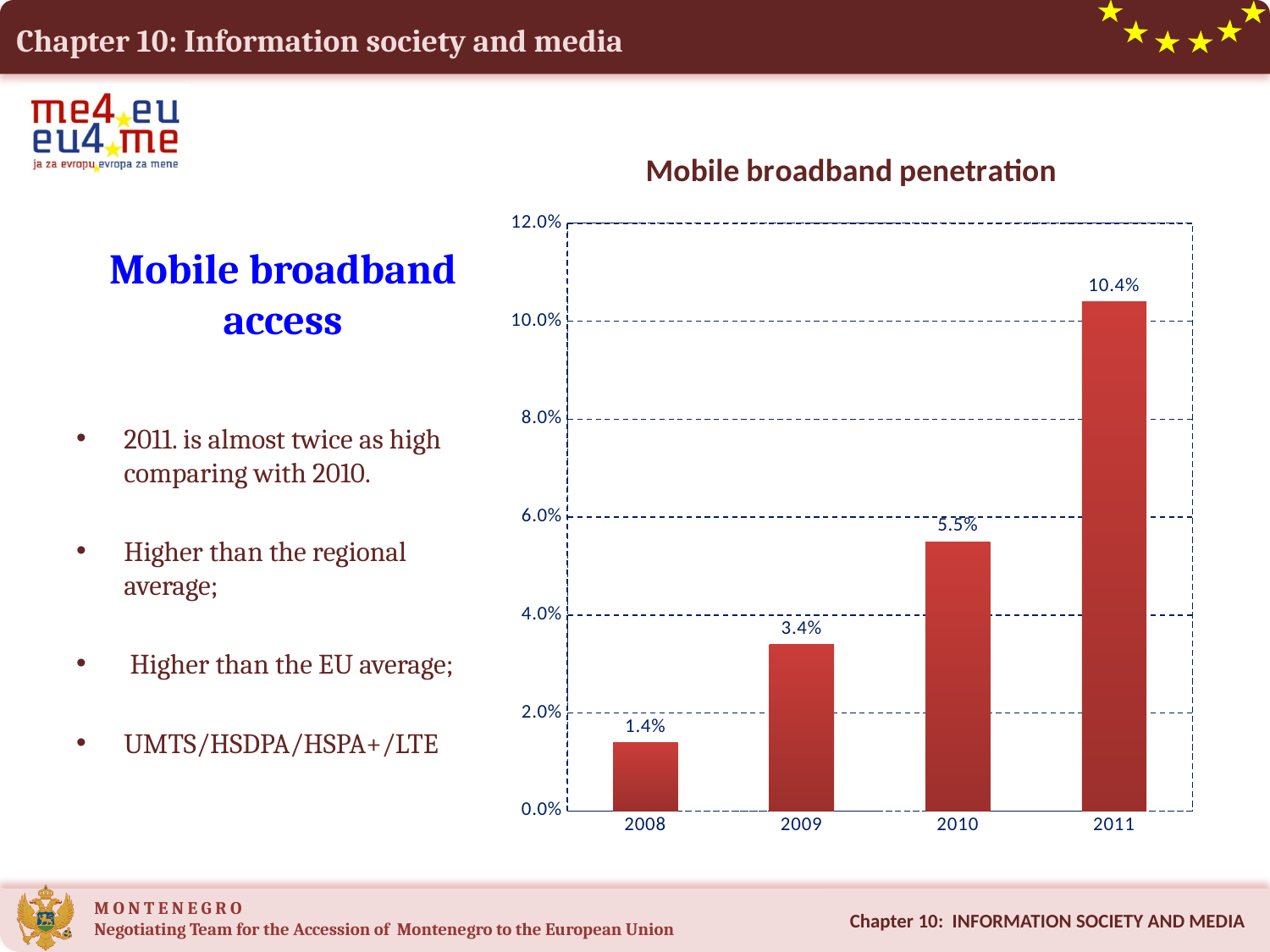
What is the mobile broadband penetration value for 2011? 10.4% Which year has the highest mobile broadband penetration? 2011 What is the difference between the 2009 and 2008 mobile broadband penetration values? 2.0% What is the mobile broadband penetration value for 2009? 3.4% Which year has the lowest mobile broadband penetration? 2008 Does mobile broadband penetration rise or fall from 2008 to 2011? rise How many years are shown on the x axis of the chart? 4 What kind of chart is used to show mobile broadband penetration? bar chart Which year has a larger mobile broadband penetration, 2009 or 2010? 2010 What is the difference between the 2011 and 2010 mobile broadband penetration values? 4.9% What is the mobile broadband penetration value for 2008? 1.4% Is the mobile broadband penetration value for 2010 greater or less than 6.0%? less